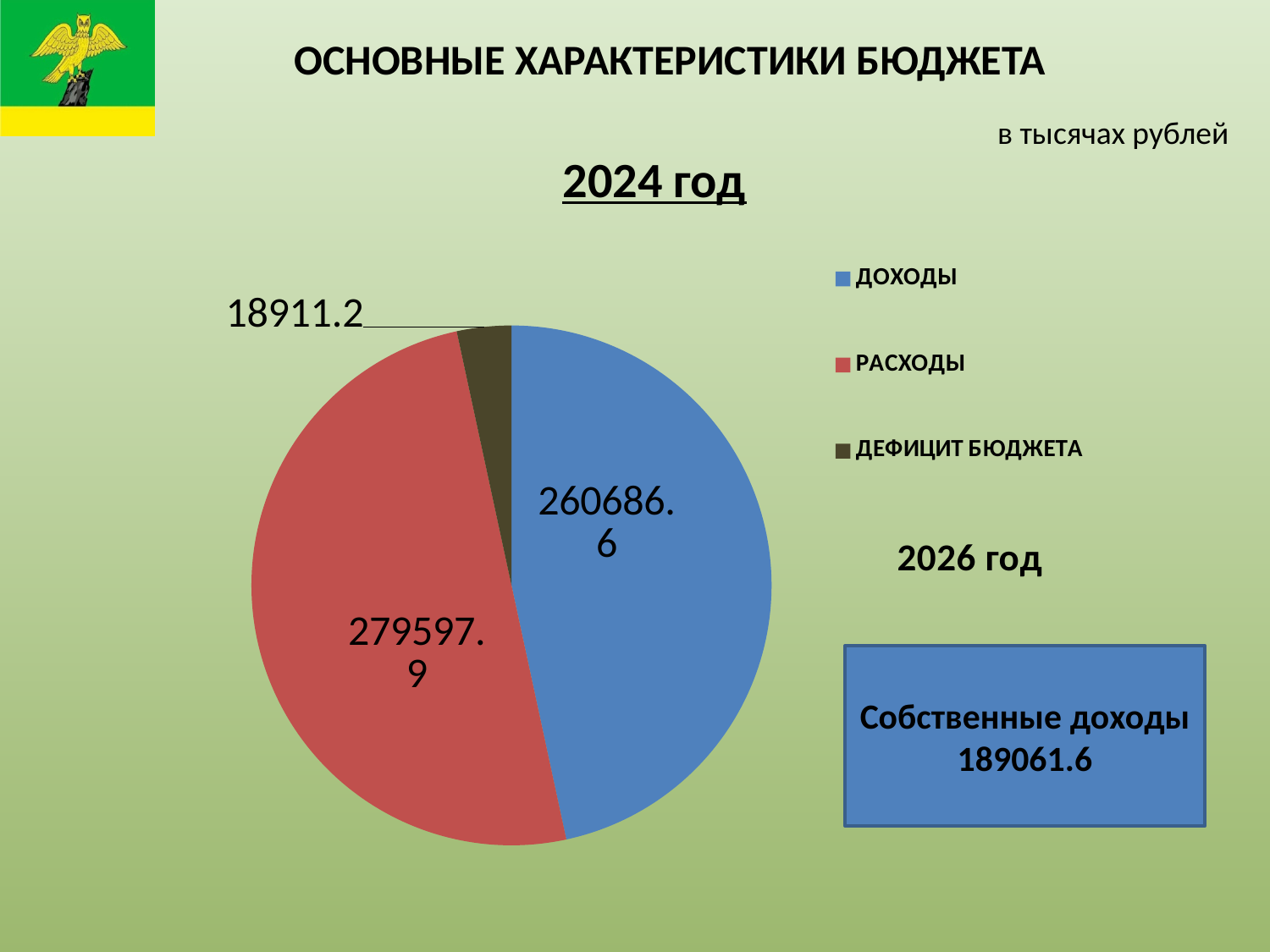
What is the value for ДОХОДЫ in the pie chart? 260686.6 Which category has the smallest slice in the pie chart? ДЕФИЦИТ БЮДЖЕТА What is the difference between the values for РАСХОДЫ and ДОХОДЫ in the pie chart? 18911.3 Which is larger in the pie chart, ДОХОДЫ or РАСХОДЫ? РАСХОДЫ What is the value for РАСХОДЫ in the pie chart? 279597.9 What kind of chart is shown on the slide? Pie chart Which category has the largest slice in the pie chart? РАСХОДЫ How many entries does the legend of the pie chart list? 3 What is the title shown above the pie chart? 2024 год How many slices does the pie chart have? 3 What colour is the ДОХОДЫ slice in the pie chart? Blue What is the value for ДЕФИЦИТ БЮДЖЕТА in the pie chart? 18911.2